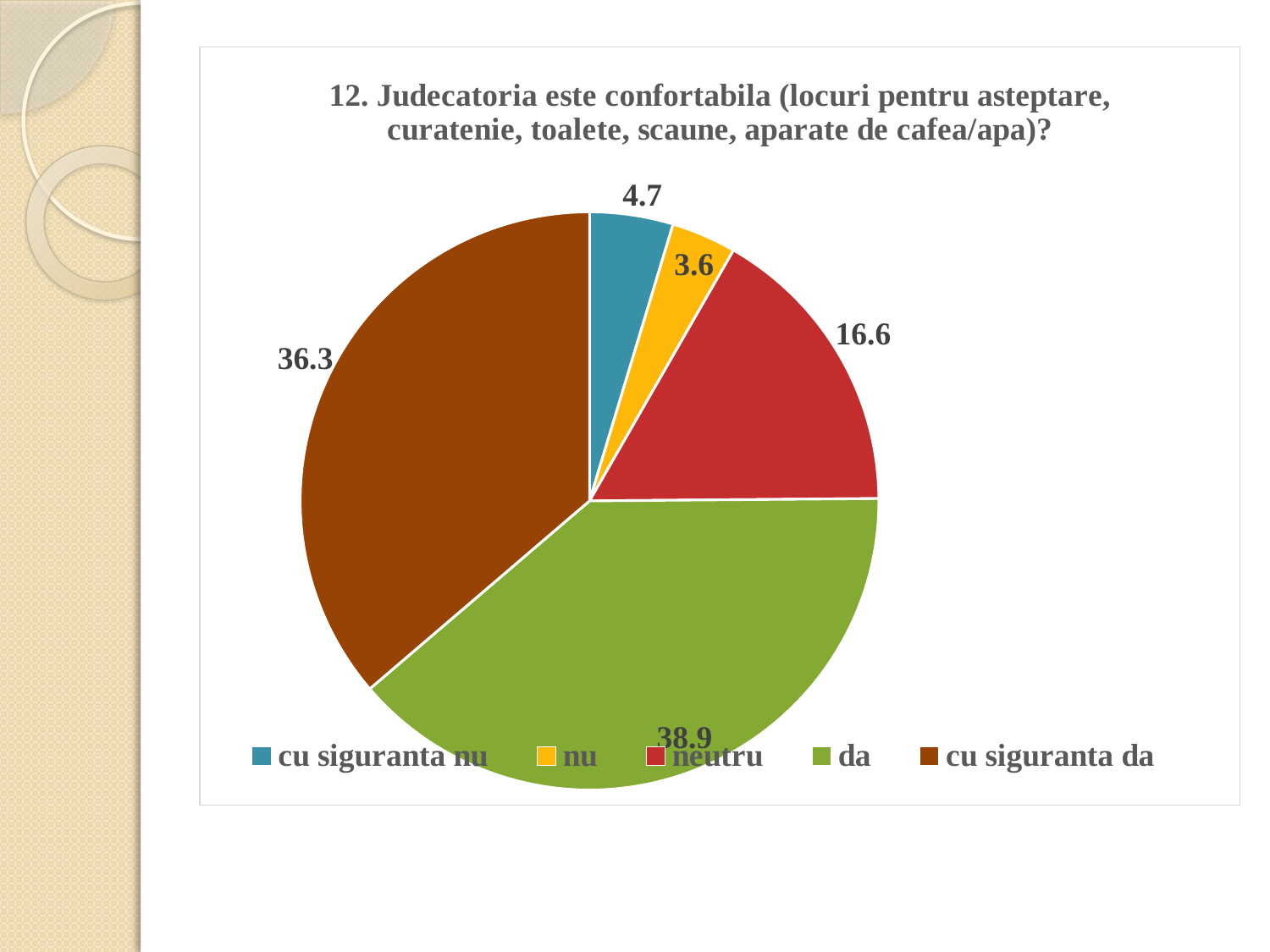
Which category has the smallest slice? nu How many categories does the pie chart have? 5 What is the difference between the values for "da" and "cu siguranta da"? 2.6 What is the value for "nu"? 3.6 What is the value for "cu siguranta nu"? 4.7 What colour is the slice for "neutru"? red What is the value for "cu siguranta da"? 36.3 What is the value for "da"? 38.9 Which is larger, the value for "neutru" or the value for "cu siguranta nu"? neutru What kind of chart is shown on the slide? pie chart What is the value for "neutru"? 16.6 Which category has the largest slice? da